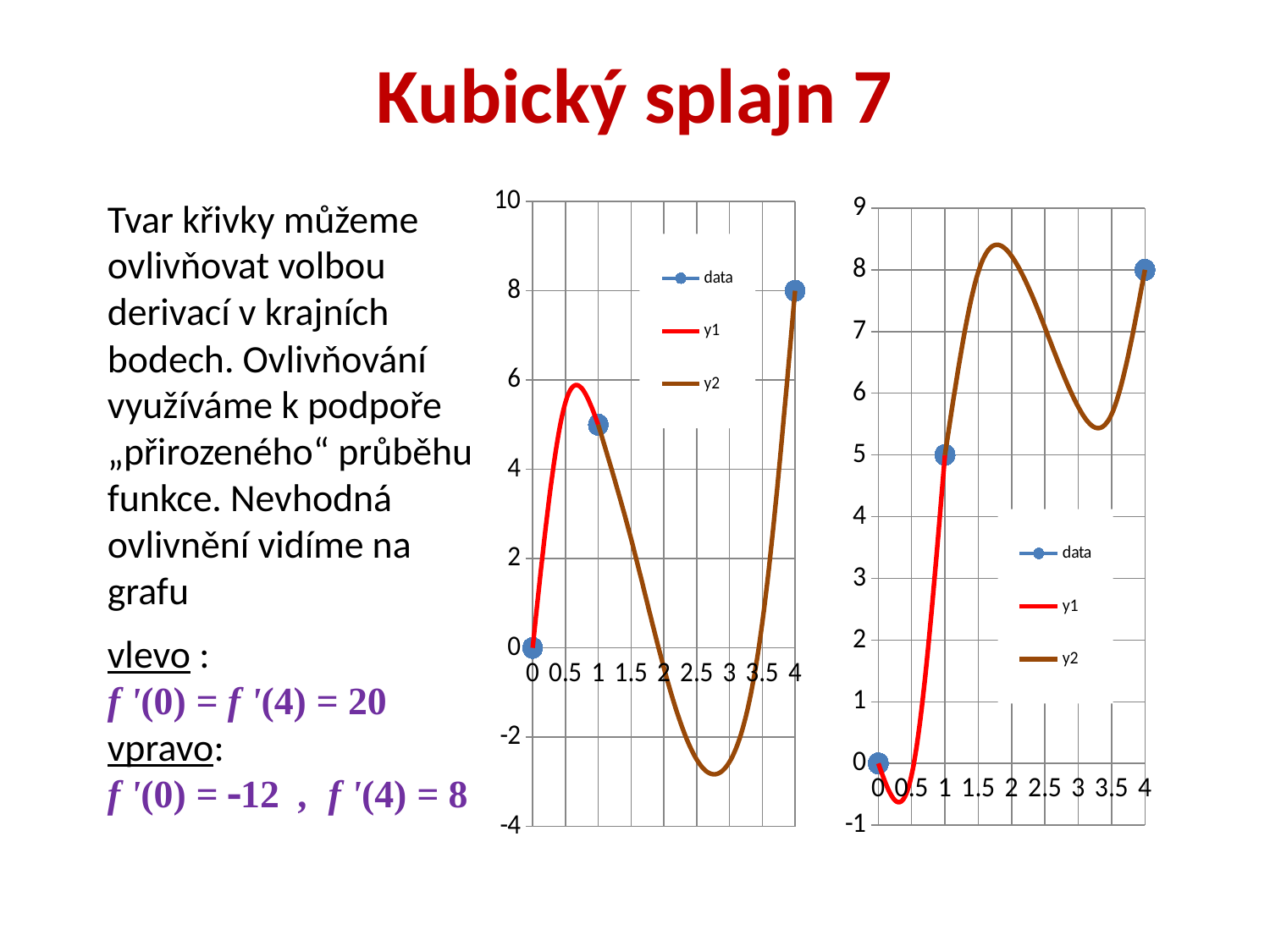
In the right chart, what is the difference between the 'data' values at x = 4 and x = 1? 3 How many series does the legend of the right chart list? 3 In the left chart, how many points does the 'data' series have? 3 What kind of chart is the left chart? line chart In the right chart, what is the value of the 'data' series at x = 1? 5 In the left chart, is the lowest value reached by the y2 curve greater or less than -2? less In the left chart, what is the value of the 'data' series at x = 4? 8 In the right chart, is the highest value reached by the y2 curve greater or less than 7? greater In the left chart, at which x value is the 'data' series highest? 4 In the right chart, at which x value is the 'data' series lowest? 0 How many series does the legend of the left chart list? 3 What is the highest tick value on the y axis of the left chart? 10